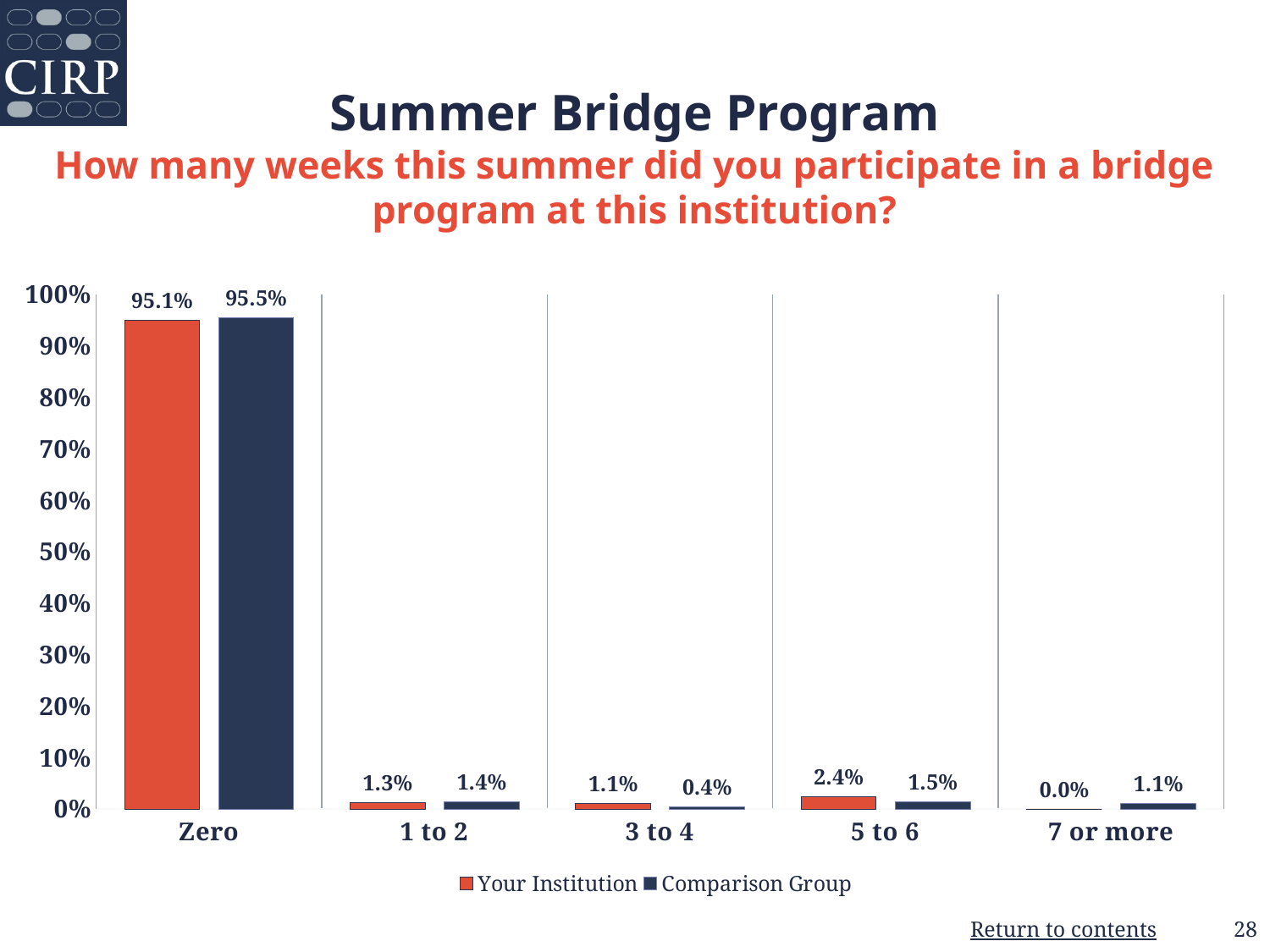
What is the value for Comparison Group in the 3 to 4 category? 0.4% What is the value for Comparison Group in the 5 to 6 category? 1.5% What kind of chart is shown on the slide? Bar chart What is the difference between the Comparison Group and Your Institution values in the Zero category? 0.4% Is the value for Your Institution in the Zero category greater or less than 90%? greater Which category has the highest value for Your Institution? Zero In the 5 to 6 category, which series has the larger value, Your Institution or Comparison Group? Your Institution What is the value for Your Institution in the 7 or more category? 0.0% How many categories are shown on the x axis? 5 Which category has the lowest value for Comparison Group? 3 to 4 How many series does the legend list? 2 What is the value for Your Institution in the Zero category? 95.1%